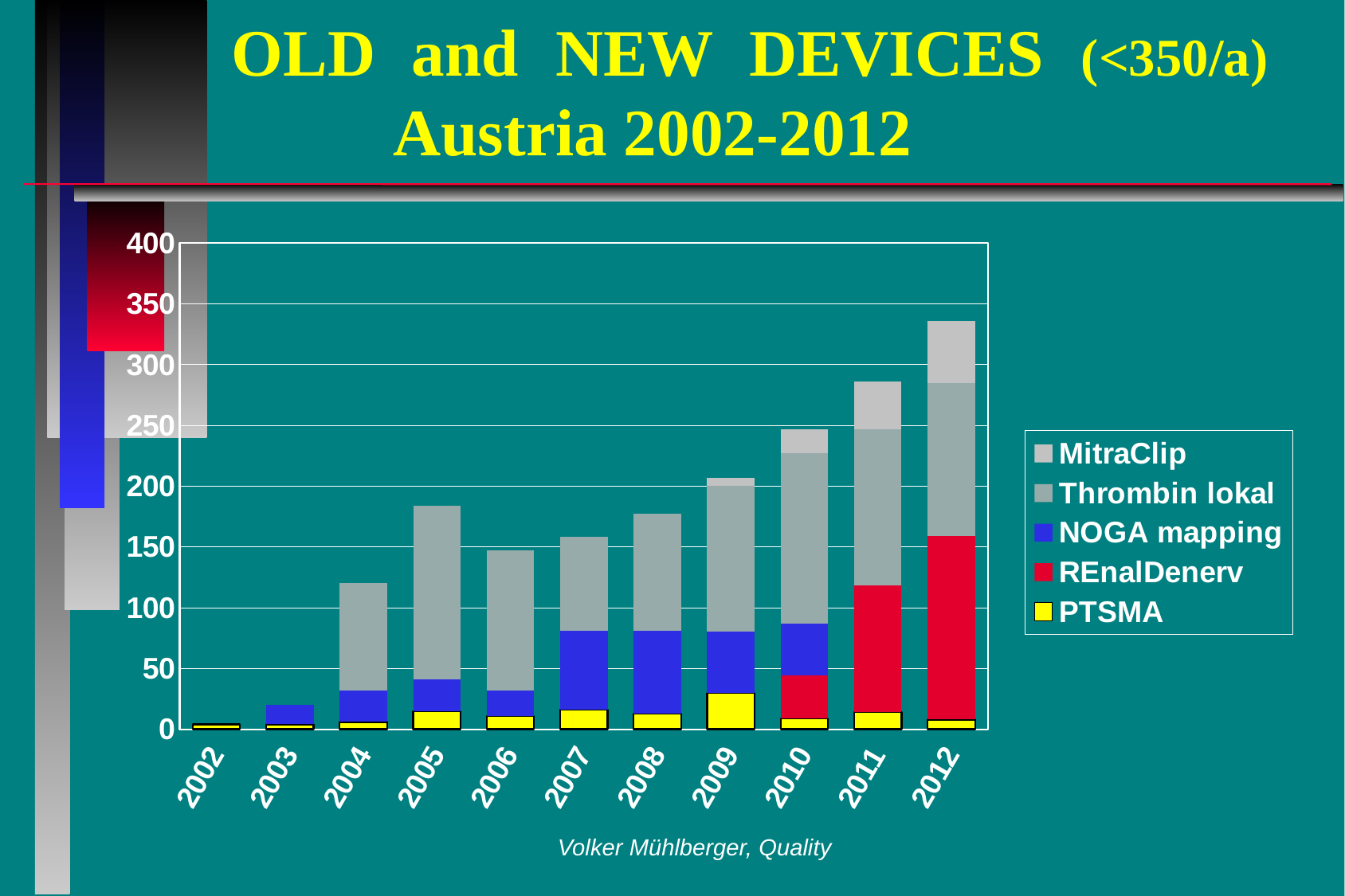
Is the total for 2011 greater or less than 250? greater Is the total for 2005 greater or less than 200? less How many years are shown on the x axis of the chart? 11 Is the total for 2012 greater or less than 300? greater Which year has the shortest stacked bar? 2002 Do the stacked bar totals generally rise or fall from 2002 to 2012? rise How many series does the legend list? 5 Which colour represents REnalDenerv in the legend? red Which year has the tallest stacked bar? 2012 Which year has the taller stacked bar, 2005 or 2006? 2005 What kind of chart is shown on the slide? stacked bar chart